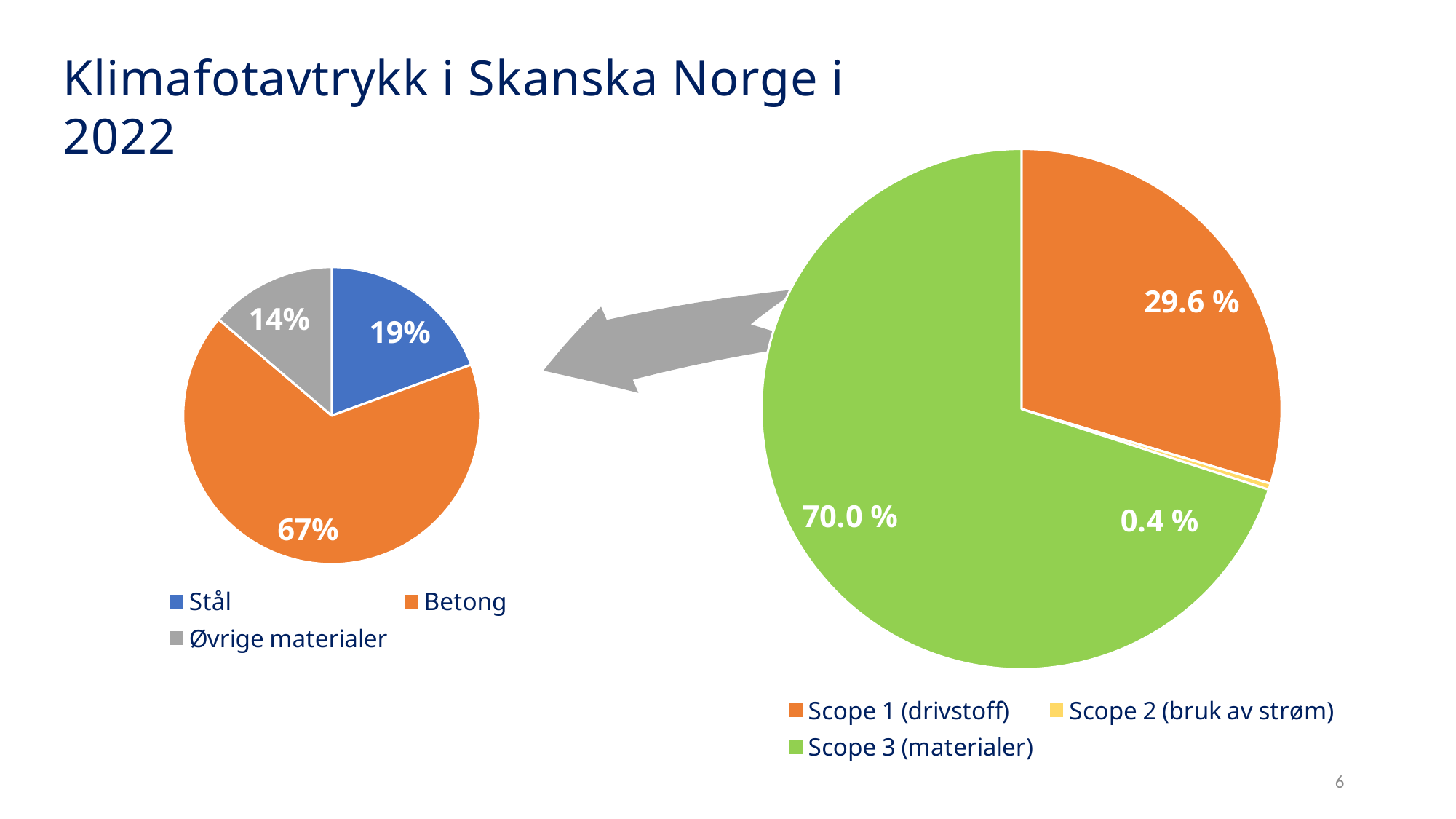
On the left-hand pie chart, which category has the largest share? Betong On the left-hand pie chart, what share does Betong have? 67% On the right-hand pie chart, what share does Scope 1 (drivstoff) have? 29.6 % What kind of chart is the left-hand chart? Pie chart On the right-hand pie chart, how many categories does the legend list? 3 On the left-hand pie chart, what share does Stål have? 19% On the left-hand pie chart, what is the difference between the shares of Stål and Øvrige materialer? 5% On the right-hand pie chart, what share does Scope 2 (bruk av strøm) have? 0.4 % On the right-hand pie chart, what share does Scope 3 (materialer) have? 70.0 % On the right-hand pie chart, which category has the largest share? Scope 3 (materialer) On the left-hand pie chart, what share does Øvrige materialer have? 14% On the right-hand pie chart, which category has the smallest share? Scope 2 (bruk av strøm)